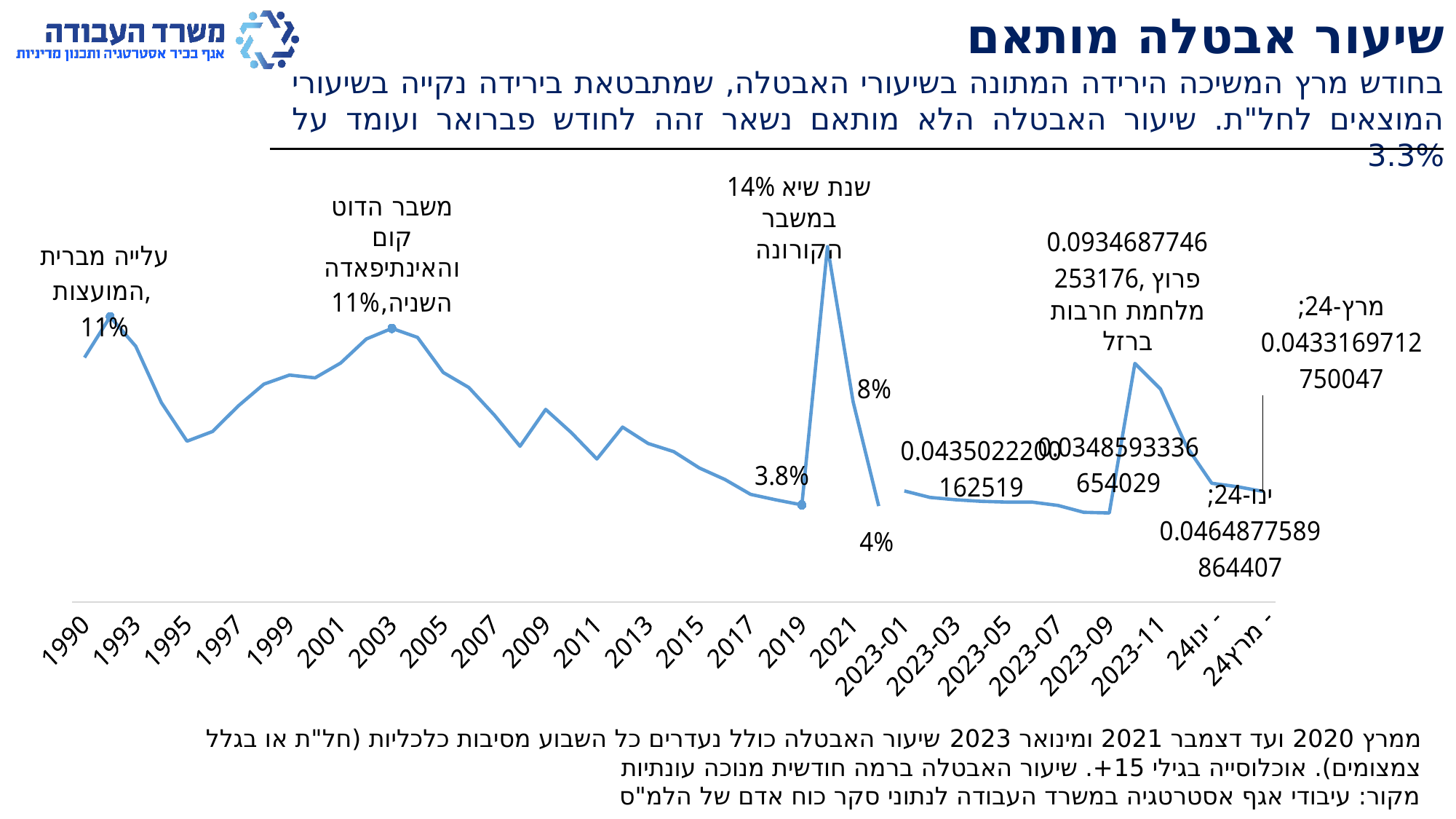
What value is labelled for ינו-24 (January 2024)? 0.0464877589864407 Which labelled point is higher: the 2003 dot-com crisis point or the 2019 point? 2003 dot-com crisis point What value is labelled at the point annotated as the outbreak of the Iron Swords war (פרוץ מלחמת חרבות ברזל)? 0.0934687746253176 What unemployment rate is labelled at the 2019 point on the chart? 3.8% Which annotated event has the highest unemployment rate on the chart? the corona crisis (14%) What value is labelled for מרץ-24 (March 2024)? 0.0433169712750047 What is the peak unemployment rate labelled during the corona crisis (שנת שיא במשבר הקורונה)? 14% What kind of chart is shown on the slide? line chart Does the unemployment rate generally rise or fall between 2003 and 2019? fall Which value is larger: ינו-24 or מרץ-24? ינו-24 What is the difference between the corona-crisis peak (14%) and the 2019 value (3.8%)? 10.2% What unemployment rate is labelled at the point annotated as the rise in immigration from the Soviet Union (עלייה מברית המועצות)? 11%